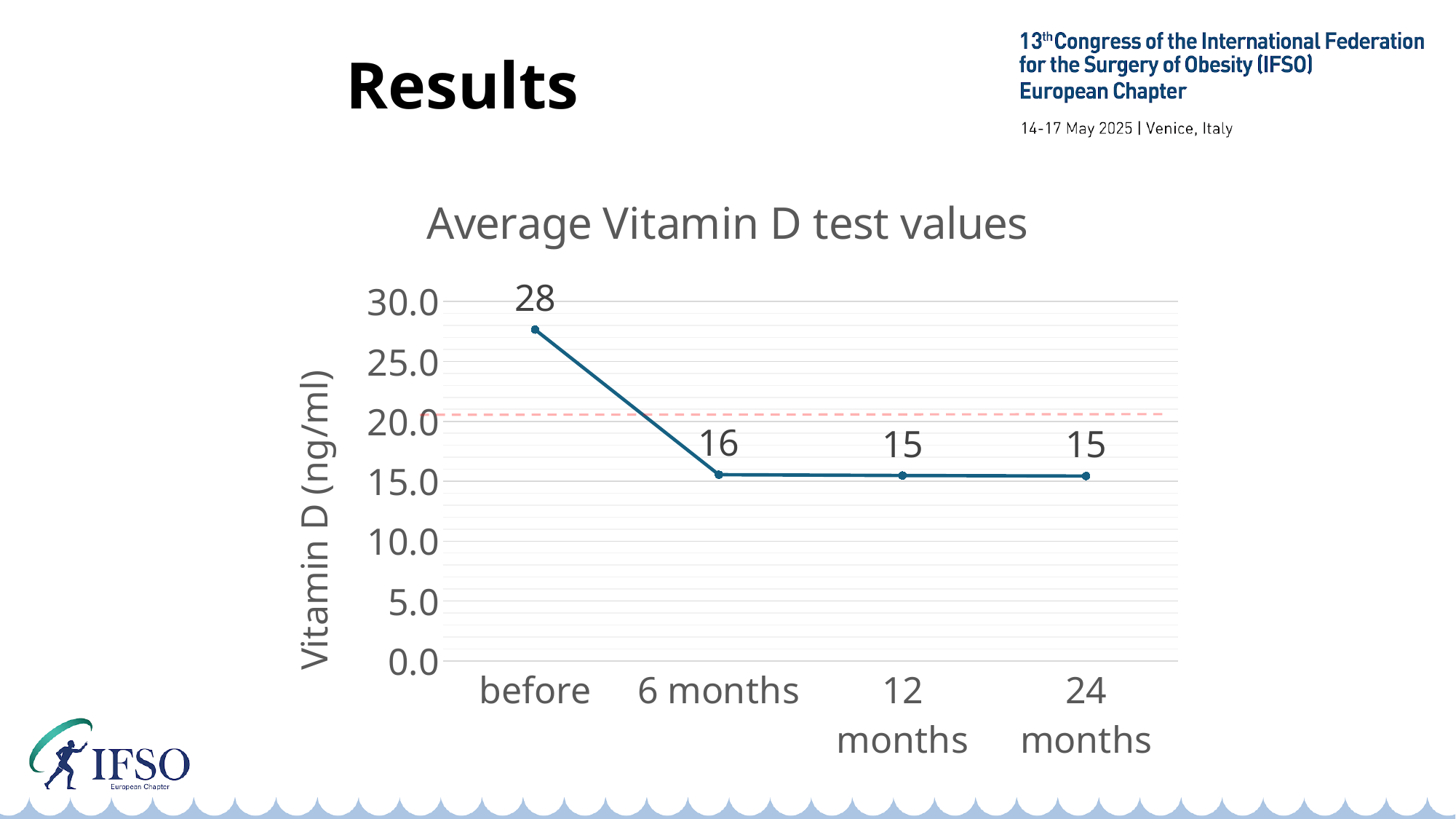
Is the Vitamin D value at 6 months greater or less than 20.0? less Which time point has the highest average Vitamin D test value? before What is the average Vitamin D test value at 24 months? 15 Do the Vitamin D values rise or fall from before to 6 months? fall How many time points are plotted on the chart? 4 What is the average Vitamin D test value at 6 months? 16 Which is larger, the Vitamin D value before or at 12 months? before What is the difference between the Vitamin D value before and at 24 months? 13 What is the difference between the Vitamin D value before and at 6 months? 12 What kind of chart is shown on the slide? line chart What is the average Vitamin D test value before? 28 What is the average Vitamin D test value at 12 months? 15